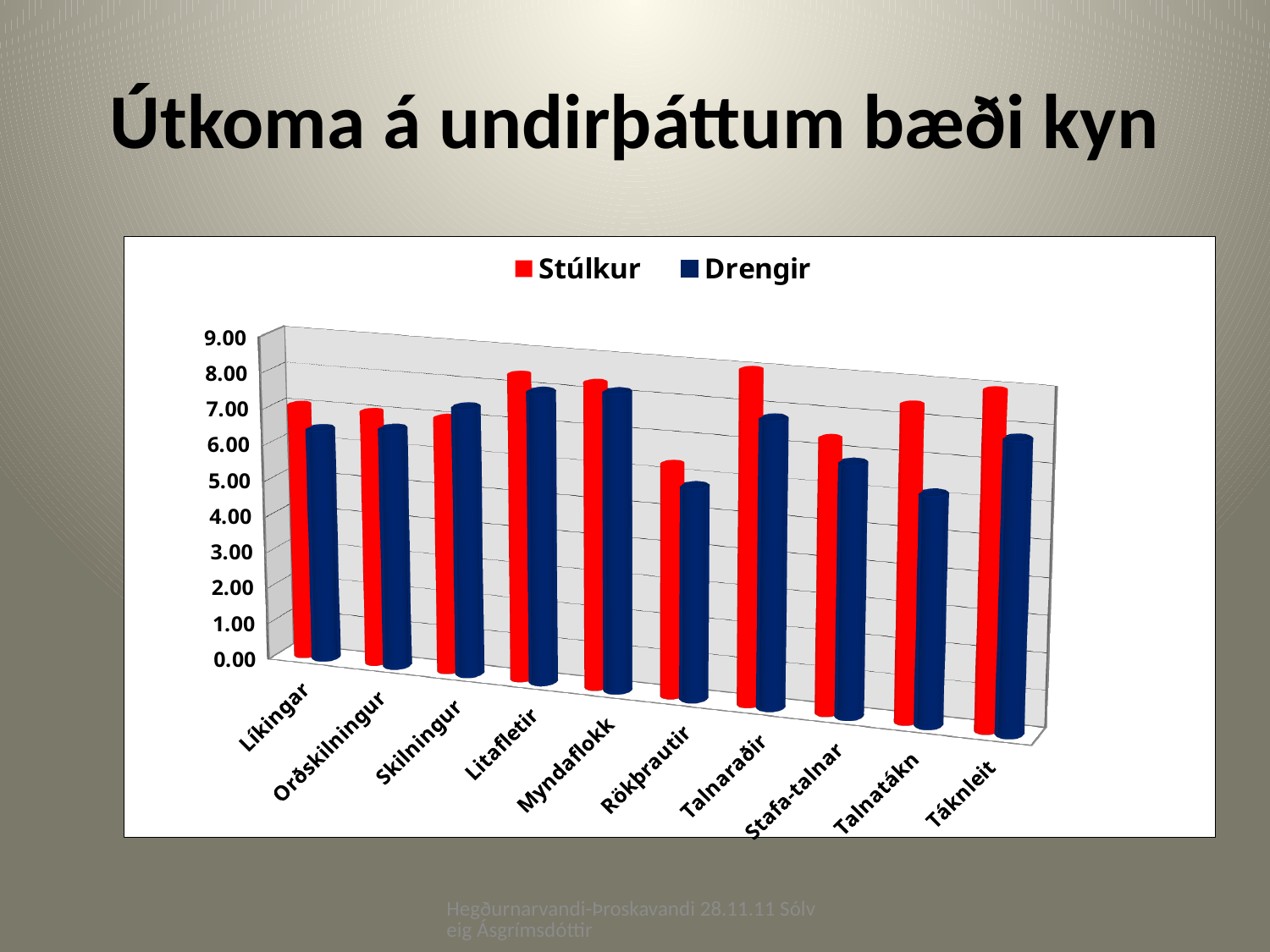
Which series is shown in red in the legend? Stúlkur For Talnaraðir, which series has the larger value, Stúlkur or Drengir? Stúlkur Is the Stúlkur value for Talnaraðir greater or less than 7.00? greater How many series does the legend list? 2 For Talnatákn, which series has the larger value, Stúlkur or Drengir? Stúlkur What is the title of the slide containing the chart? Útkoma á undirþáttum bæði kyn What kind of chart is shown on the slide? bar chart How many categories are shown on the x axis? 10 Which category has the lowest value for Stúlkur? Rökþrautir Is the Drengir value for Litafletir greater or less than 6.00? greater